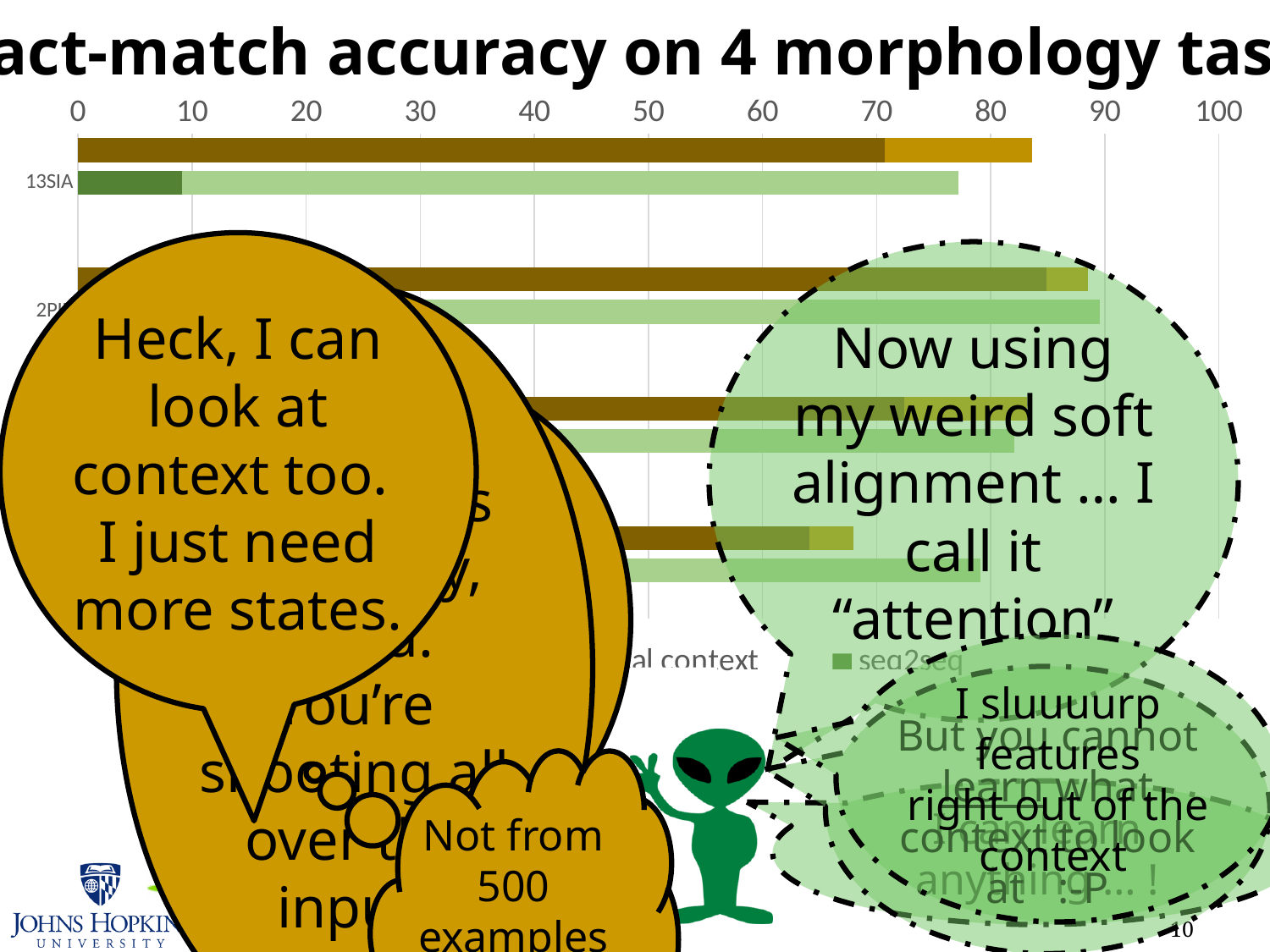
How many morphology tasks does the chart title say the accuracy is measured on? 4 Which of the four bars for 13SIA is the longest? the dark brown bar Is the value of the dark green bar for 13SIA greater or less than 20? less Which of the four bars for 13SIA is the shortest? the dark green bar Is the value of the dark brown bar for 13SIA greater or less than 60? greater Is the value of the light green bar for 13SIA greater or less than 80? less What is the highest value shown on the x axis of the chart? 100 What kind of chart is shown on the slide? bar chart